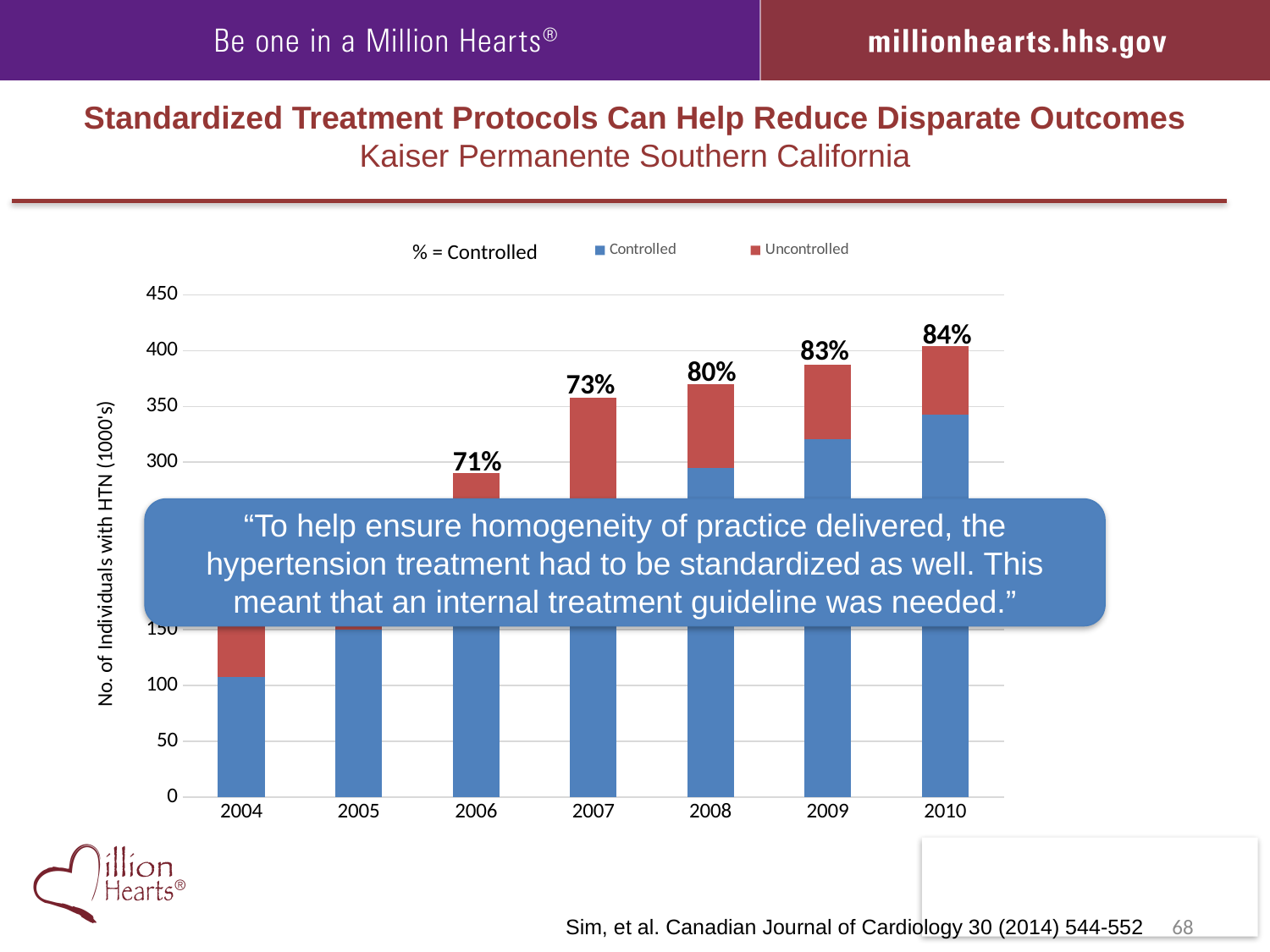
What controlled percentage is labeled above the 2008 bar? 80% Which year has the highest labeled controlled percentage? 2010 How many years are shown on the x axis of the chart? 7 Which year has the higher controlled percentage, 2007 or 2009? 2009 How many series does the chart legend list? 2 By how many percentage points did the controlled percentage increase from 2006 to 2010? 13 percentage points What controlled percentage is labeled above the 2006 bar? 71% Is the total height of the 2009 bar greater or less than 400? less Do the labeled controlled percentages rise or fall from 2006 to 2010? rise Is the total height of the 2006 bar greater or less than 300? less What percentage of individuals had controlled hypertension in 2010? 84%